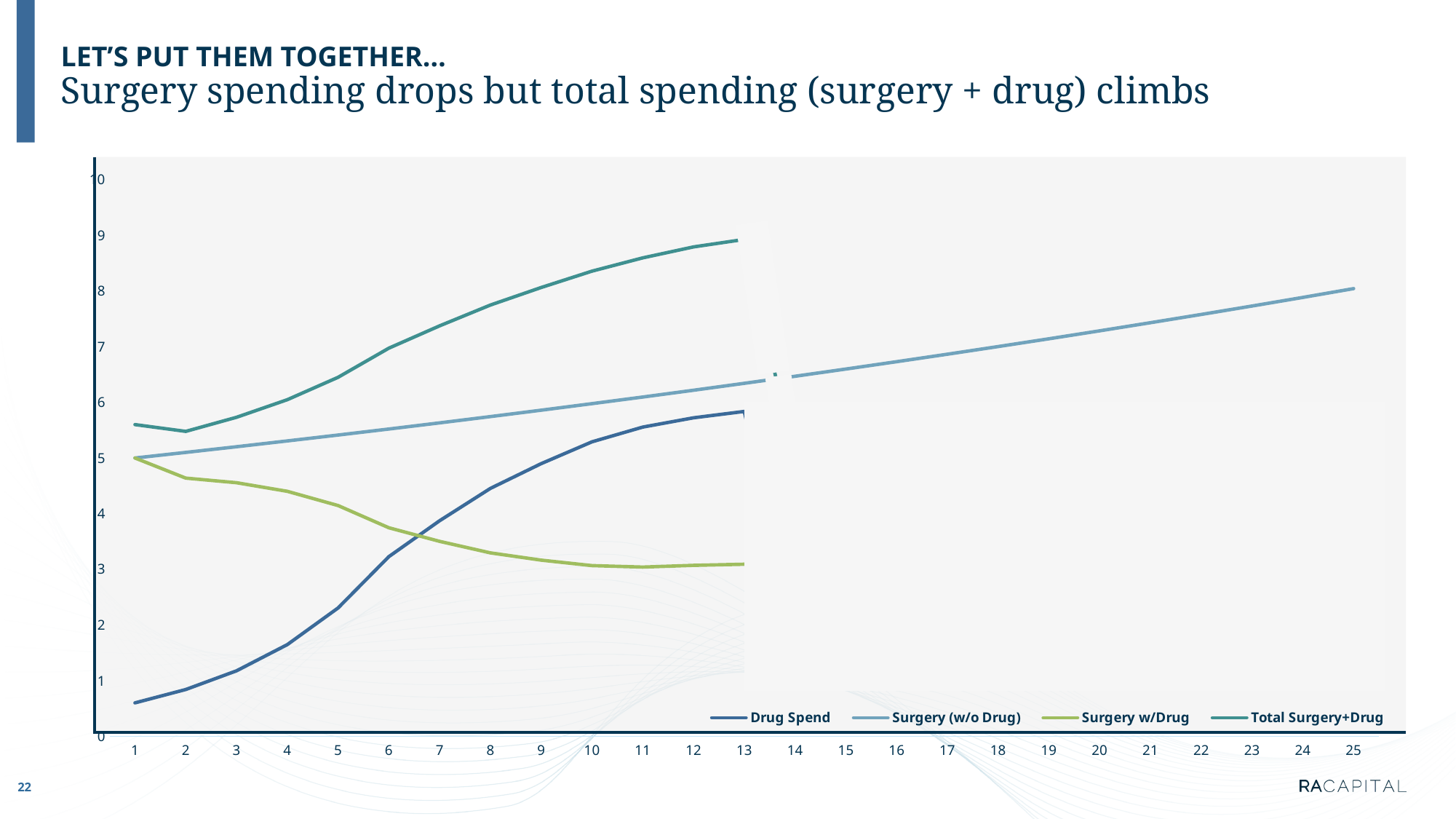
Which series has the highest value at x = 13? Total Surgery+Drug Does the Drug Spend line rise or fall as the x axis increases? rises Does the Surgery w/Drug line rise or fall as the x axis increases? falls How many series does the legend list? 4 Which series has the lowest value at x = 1? Drug Spend At x = 13, which is larger: Total Surgery+Drug or Surgery w/Drug? Total Surgery+Drug Is the value for Total Surgery+Drug at x = 13 greater or less than 8? greater Is the value for Surgery (w/o Drug) at x = 25 greater or less than 7? greater Is the value for Drug Spend at x = 1 greater or less than 1? less What kind of chart is shown on the slide? line chart How many tick labels are shown on the x axis? 25